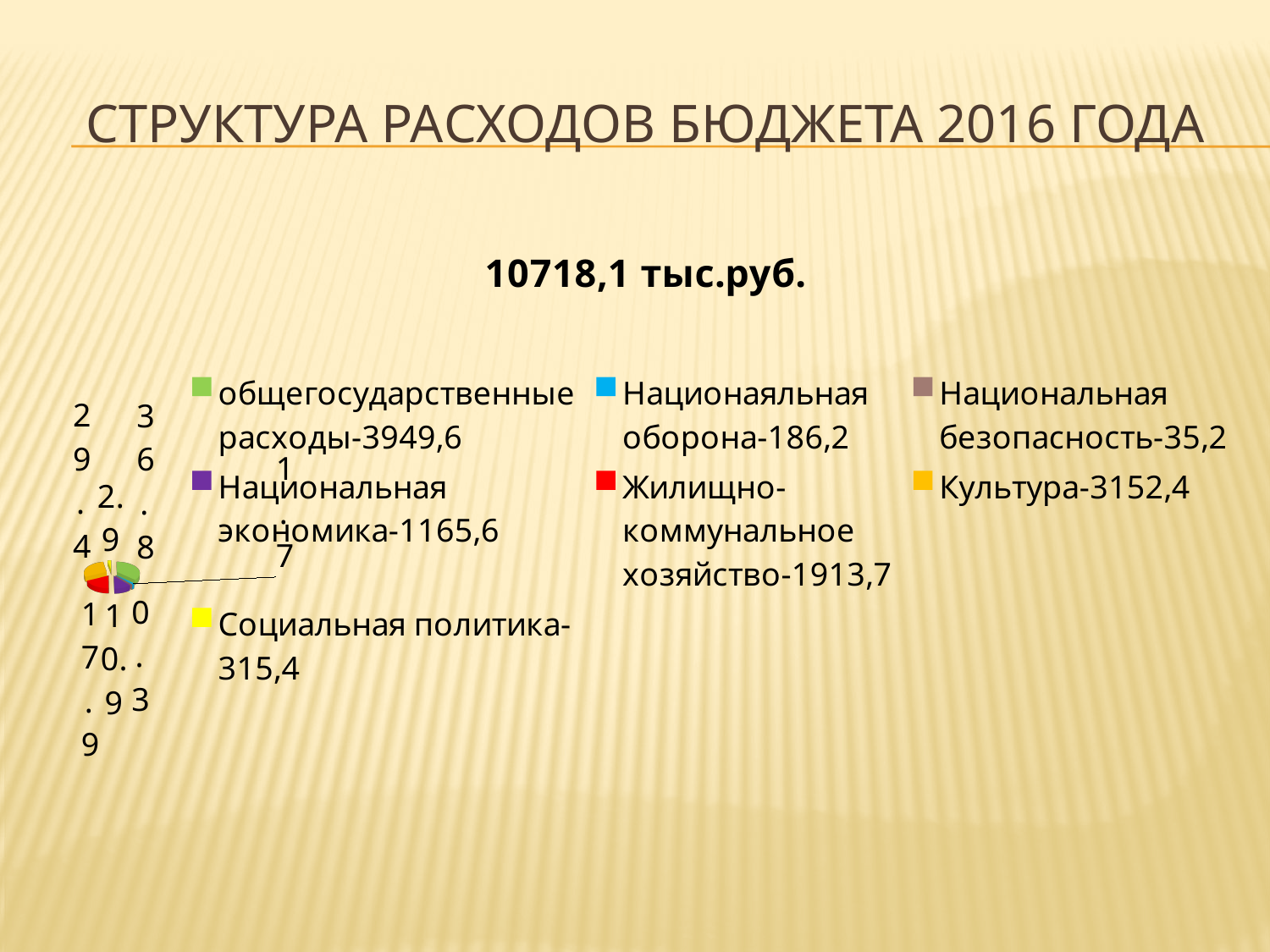
What colour is the legend marker for Культура? orange Which category has the largest value? общегосударственные расходы How many categories does the legend of the pie chart list? 7 What value is given for Жилищно-коммунальное хозяйство in the legend? 1913,7 Which category has the smallest value? Национальная безопасность What value is given for Национальная безопасность in the legend? 35,2 What is the difference between the values for общегосударственные расходы and Культура? 797,2 Which is larger: Национальная экономика or Социальная политика? Национальная экономика What value is given for общегосударственные расходы in the legend? 3949,6 What kind of chart is shown on the slide? pie chart What total amount is shown above the chart? 10718,1 тыс.руб. What value is given for Культура in the legend? 3152,4